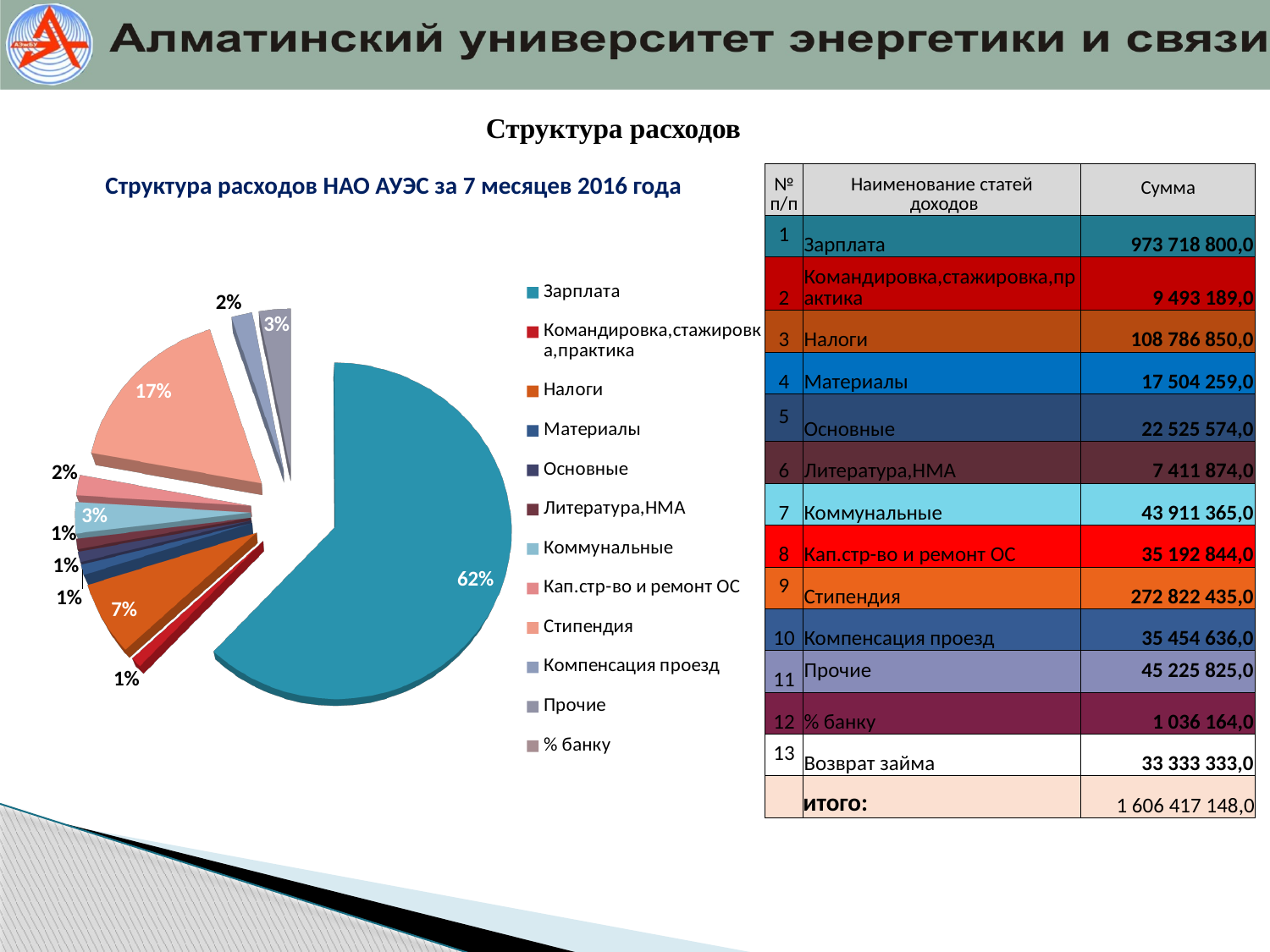
What share of expenses does Налоги account for in the pie chart? 7% What share of expenses does Стипендия account for in the pie chart? 17% By how many percentage points does the Зарплата slice exceed the Стипендия slice? 45 What share of expenses does Компенсация проезд account for in the pie chart? 2% Which category has the largest slice in the pie chart? Зарплата What kind of chart is shown on the slide? pie chart Which slice is larger, Стипендия or Налоги? Стипендия What is the title of the chart? Структура расходов НАО АУЭС за 7 месяцев 2016 года How many categories does the chart's legend list? 12